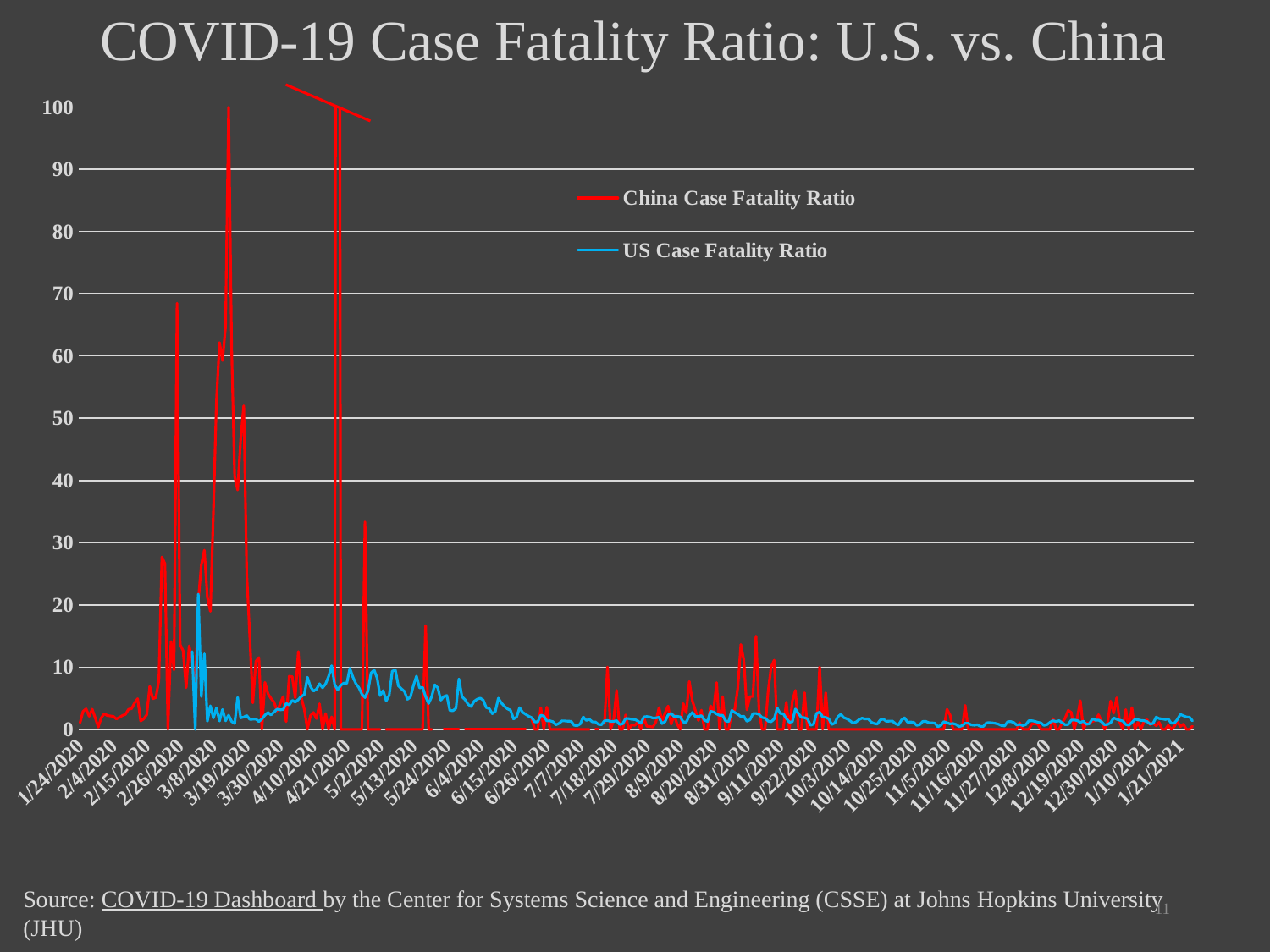
How many series does the legend list? 2 Is the highest value of the China Case Fatality Ratio greater or less than 90? greater Is the highest value of the US Case Fatality Ratio greater or less than 30? less What is the highest value shown on the vertical axis? 100 What is the title of the chart? COVID-19 Case Fatality Ratio: U.S. vs. China Is the US Case Fatality Ratio on 1/21/2021 greater or less than 10? less Which colour is used for the US Case Fatality Ratio line? Blue What is the last date shown on the horizontal axis? 1/21/2021 What kind of chart is shown on the slide? Line chart Which series reaches the higher peak value, China Case Fatality Ratio or US Case Fatality Ratio? China Case Fatality Ratio Does the US Case Fatality Ratio rise or fall between 5/2/2020 and 1/21/2021? fall What is the first date shown on the horizontal axis? 1/24/2020